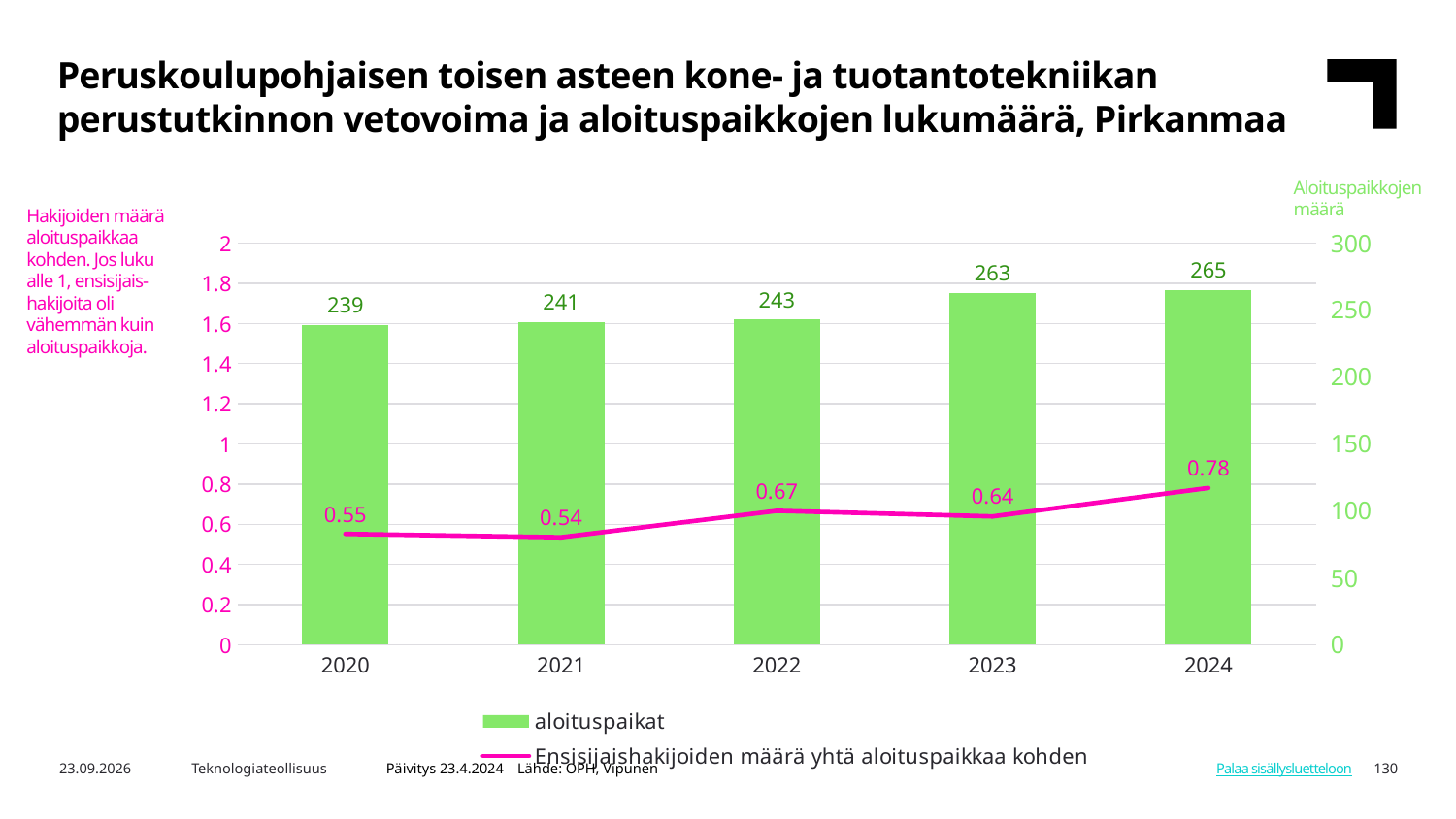
How many years are shown on the x axis? 5 Which year has the highest value for aloituspaikat? 2024 What kind of chart is used for the aloituspaikat series? bar chart What is the value of aloituspaikat for 2023? 263 Do the aloituspaikat values rise or fall from 2020 to 2024? rise Which year has the lowest value for Ensisijaishakijoiden määrä yhtä aloituspaikkaa kohden? 2021 What is the difference in aloituspaikat between 2024 and 2020? 26 What colour is the line for Ensisijaishakijoiden määrä yhtä aloituspaikkaa kohden? pink What is the value of Ensisijaishakijoiden määrä yhtä aloituspaikkaa kohden for 2024? 0.78 What is the value of aloituspaikat for 2022? 243 Which is larger, the Ensisijaishakijoiden määrä yhtä aloituspaikkaa kohden value for 2022 or for 2023? 2022 How many series does the legend list? 2